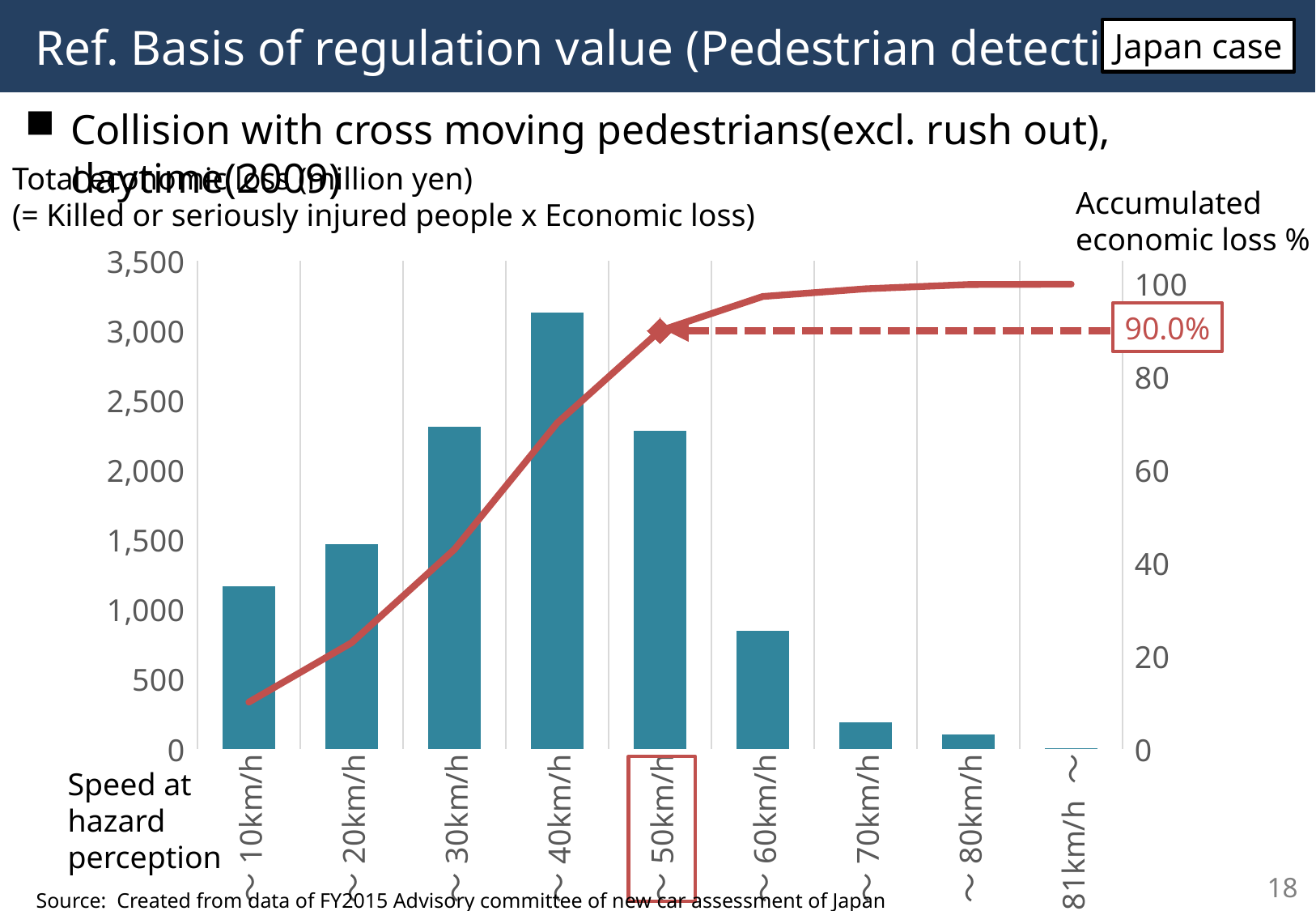
Does the accumulated economic loss % line rise or fall as speed increases along the x axis? rise Is the total economic loss bar for ~70km/h greater or less than 500? less Is the total economic loss bar for ~40km/h greater or less than 3,000? greater Which has a larger total economic loss bar, ~20km/h or ~10km/h? ~20km/h Is the total economic loss bar for ~10km/h greater or less than 1,000? greater Which has a larger total economic loss bar, ~60km/h or ~70km/h? ~60km/h Which speed category has the lowest total economic loss bar? 81km/h ~ What kind of chart is used for the total economic loss values? bar chart What accumulated economic loss percentage is labelled at the ~50km/h category? 90.0% Which speed category has the highest total economic loss bar? ~40km/h How many speed categories are shown on the x axis? 9